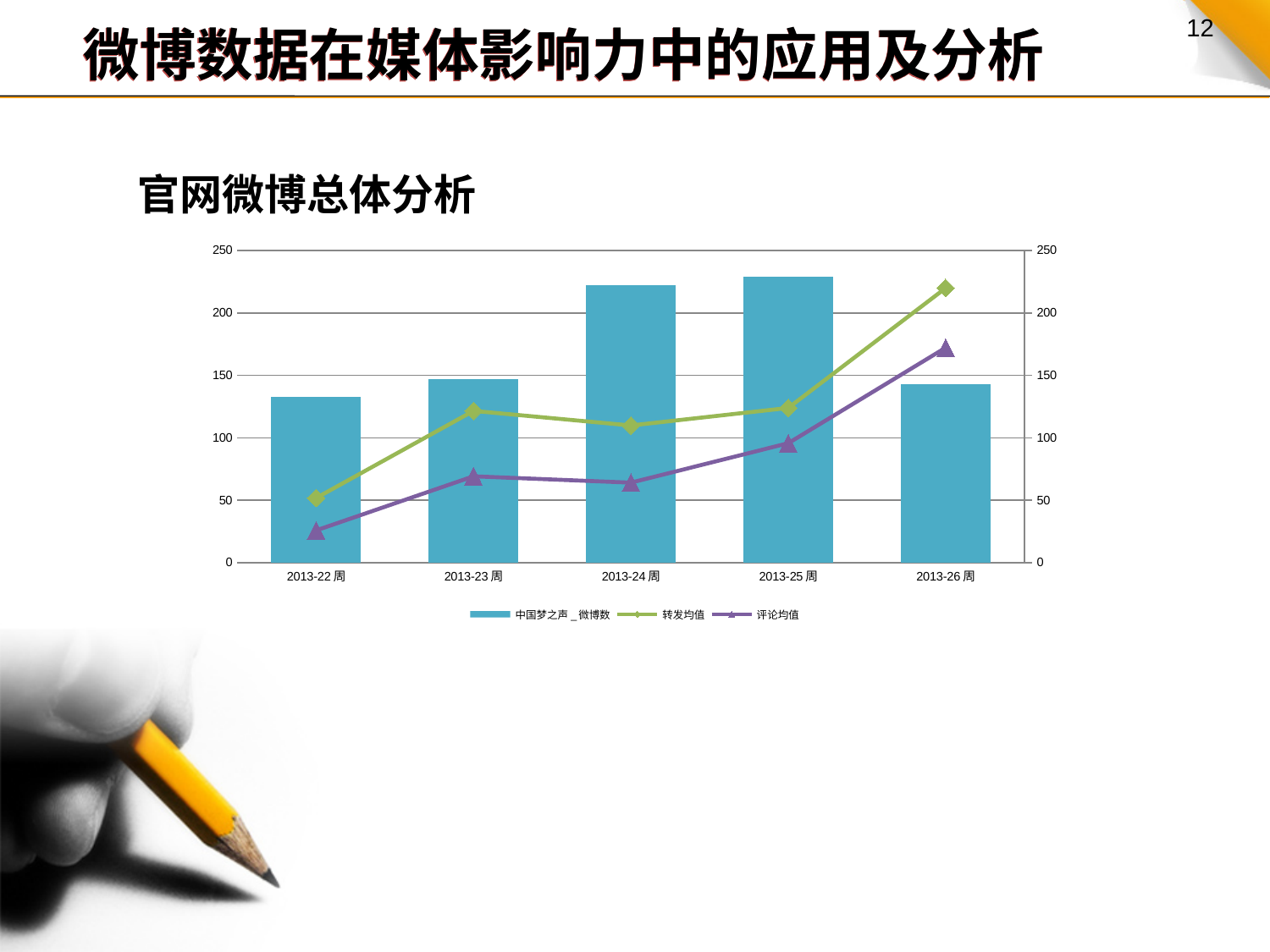
How many weeks (categories) are shown on the x axis? 5 Which series is drawn as bars? 中国梦之声_微博数 What kind of chart is shown on the slide? A combined bar and line chart In which week is the 中国梦之声_微博数 bar the highest? 2013-25 周 Is the 评论均值 value for 2013-22 周 greater or less than 50? less In which week does the 转发均值 line reach its highest value? 2013-26 周 Is the 中国梦之声_微博数 value for 2013-24 周 greater or less than 200? greater In which week is the 中国梦之声_微博数 bar the lowest? 2013-22 周 In which week is the 评论均值 line at its lowest? 2013-22 周 At 2013-25 周, which is larger, 转发均值 or 评论均值? 转发均值 Is the 转发均值 value for 2013-26 周 greater or less than 200? greater How many series does the legend list? 3